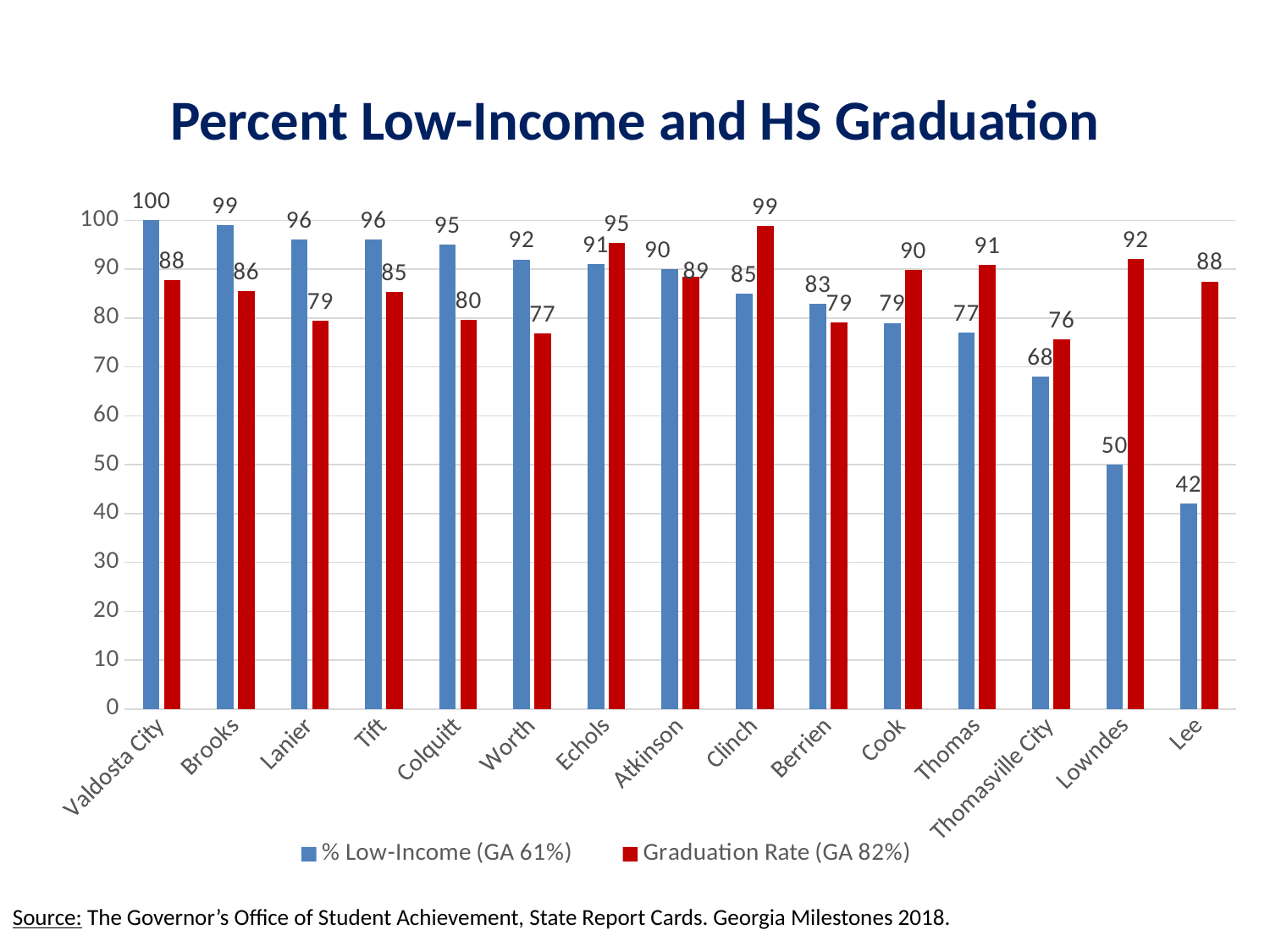
Do the % Low-Income values generally rise or fall from left to right across the x axis? Fall What kind of chart is shown on the slide? Bar chart Which district has the lowest Graduation Rate? Thomasville City Which district has the highest % Low-Income value? Valdosta City How many series does the legend list? 2 What is the Graduation Rate for Lowndes? 92 What is the % Low-Income value for Colquitt? 95 What is the difference between the % Low-Income and Graduation Rate values for Lee? 46 Which district has the lowest % Low-Income value? Lee For Clinch, which is larger: the % Low-Income value or the Graduation Rate? Graduation Rate How many districts are shown on the x axis? 15 What colour are the Graduation Rate bars? Red